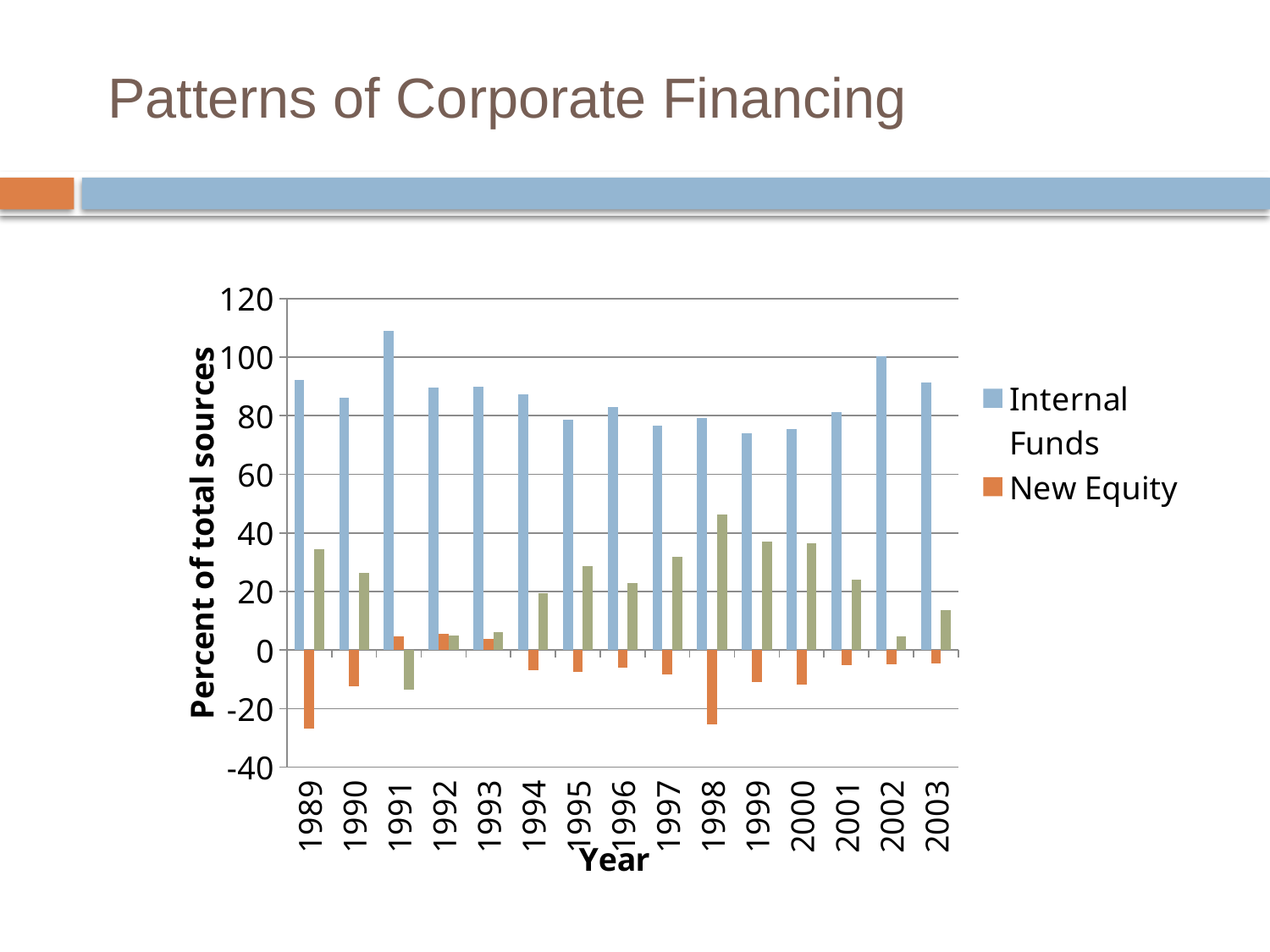
Is the Internal Funds value for 1991 greater or less than 100? greater Which year has the highest Internal Funds value? 1991 Is the Internal Funds value for 1999 greater or less than 80? less How many years are shown along the x axis of the chart? 15 What is the title of the chart's vertical axis? Percent of total sources Is the New Equity value for 1989 greater or less than -20? less How many series does the chart's legend list? 2 Which is larger, the Internal Funds value for 1989 or for 1999? 1989 What kind of chart is shown on the slide? bar chart Which is larger, the New Equity value for 1991 or for 1998? 1991